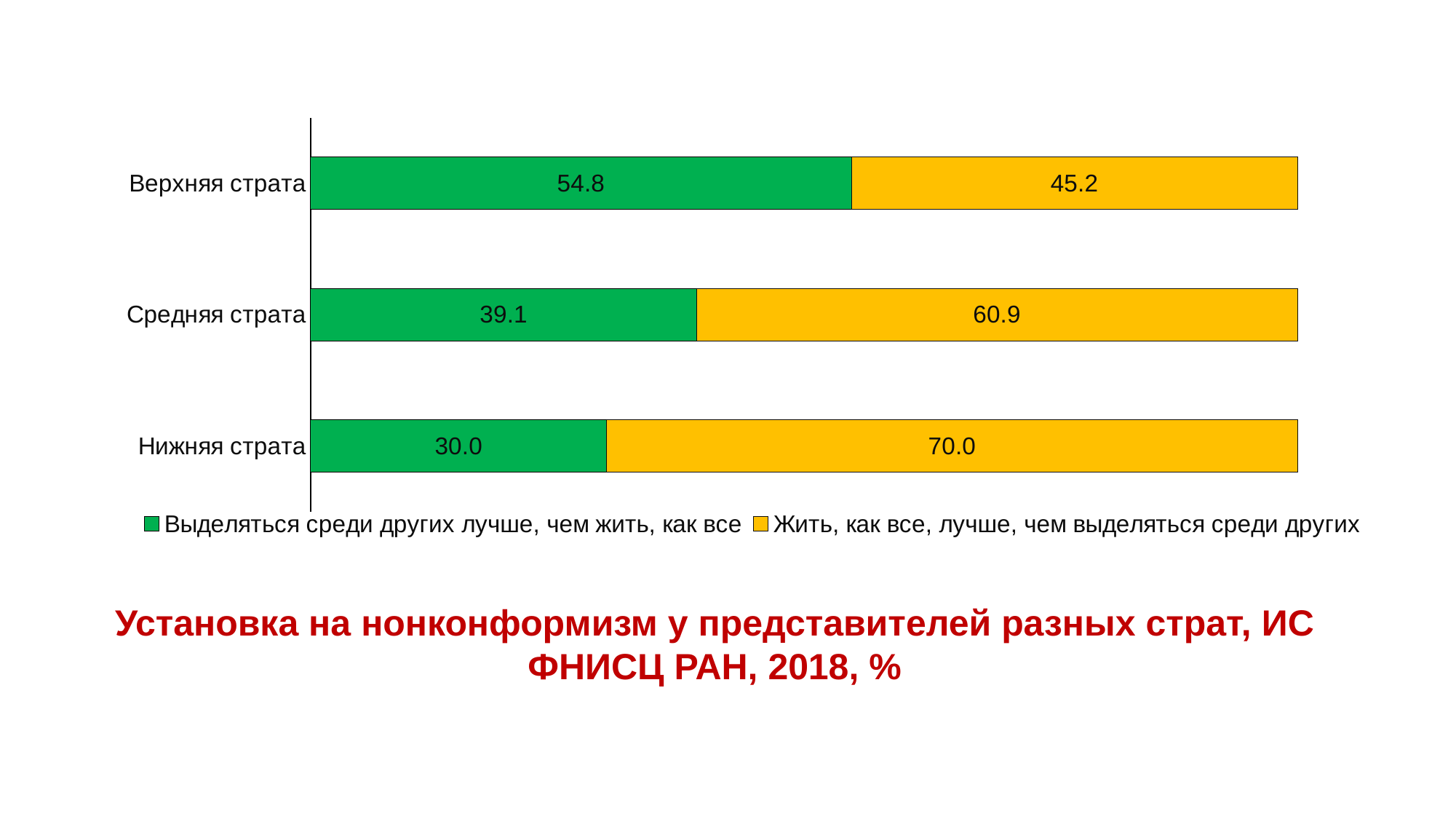
How many series does the legend list? 2 For "Средняя страта", which series has the larger value: "Выделяться среди других лучше, чем жить, как все" or "Жить, как все, лучше, чем выделяться среди других"? Жить, как все, лучше, чем выделяться среди других What is the total of the stacked bar for "Верхняя страта"? 100.0 What kind of chart is shown on the slide? Stacked bar chart Which stratum has the lowest value for "Жить, как все, лучше, чем выделяться среди других"? Верхняя страта What is the value for "Средняя страта" in the series "Выделяться среди других лучше, чем жить, как все"? 39.1 What is the value for "Верхняя страта" in the series "Выделяться среди других лучше, чем жить, как все"? 54.8 What is the value for "Нижняя страта" in the series "Жить, как все, лучше, чем выделяться среди других"? 70.0 Which stratum has the highest value for "Выделяться среди других лучше, чем жить, как все"? Верхняя страта How many strata (categories) are shown in the chart? 3 What is the difference between the "Жить, как все, лучше, чем выделяться среди других" values for "Нижняя страта" and "Верхняя страта"? 24.8 What colour represents the series "Жить, как все, лучше, чем выделяться среди других"? Yellow